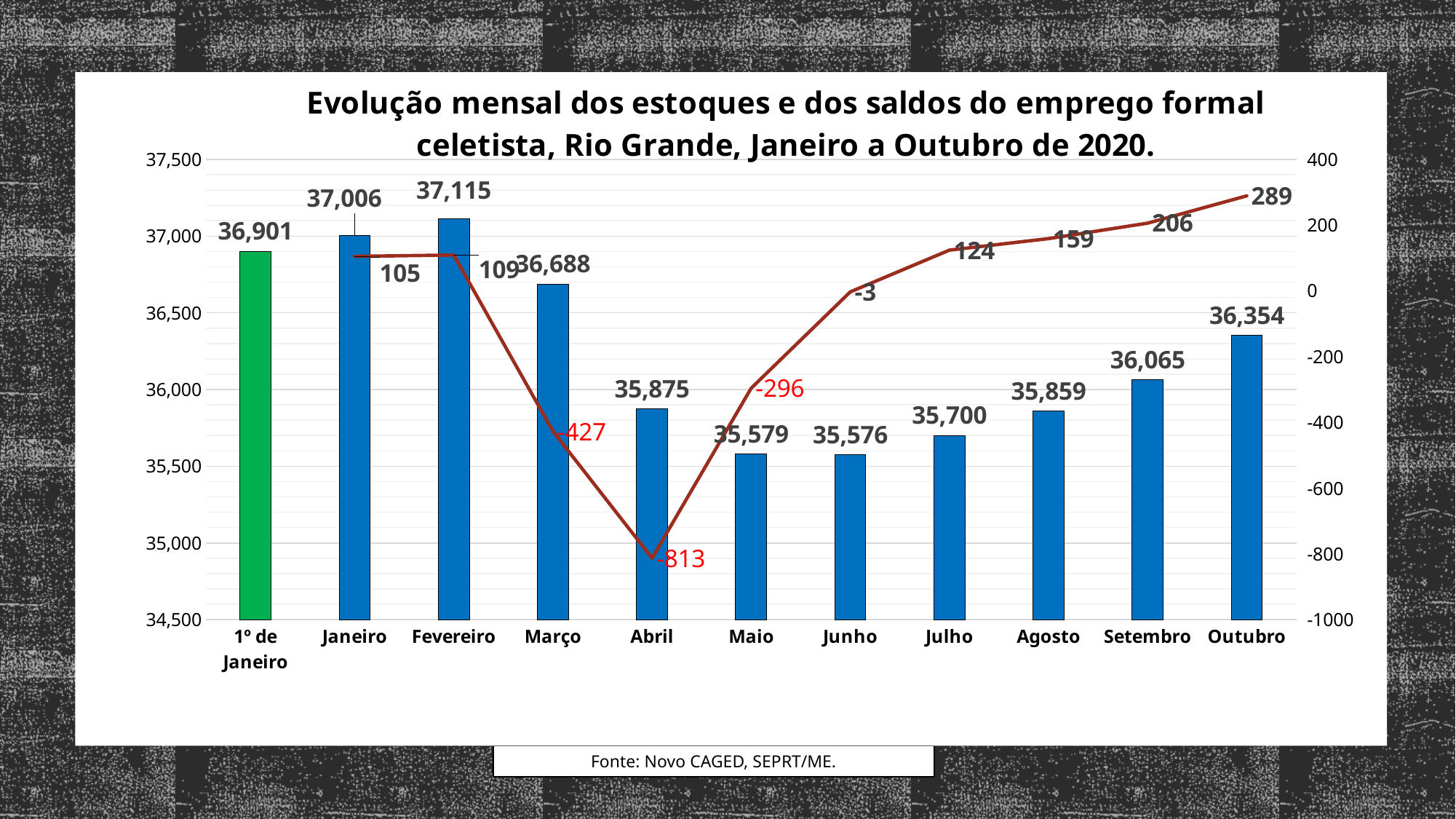
What is the stock (bar) value for Outubro? 36,354 How many bars are plotted on the chart? 11 Which month has the highest stock (bar) value? Fevereiro What is the stock (bar) value for Fevereiro? 37,115 What is the difference between the stock values for Fevereiro and Março? 427 What kind of chart is shown on the slide? Combined bar and line chart What is the saldo (line) value for Abril? -813 Which month has the lowest saldo (line) value? Abril Which is larger, the stock value for Julho or for Agosto? Agosto Is the stock value for Abril greater or less than 36,000? less Does the saldo (line) rise or fall from Abril to Outubro? rise What is the saldo (line) value for Setembro? 206